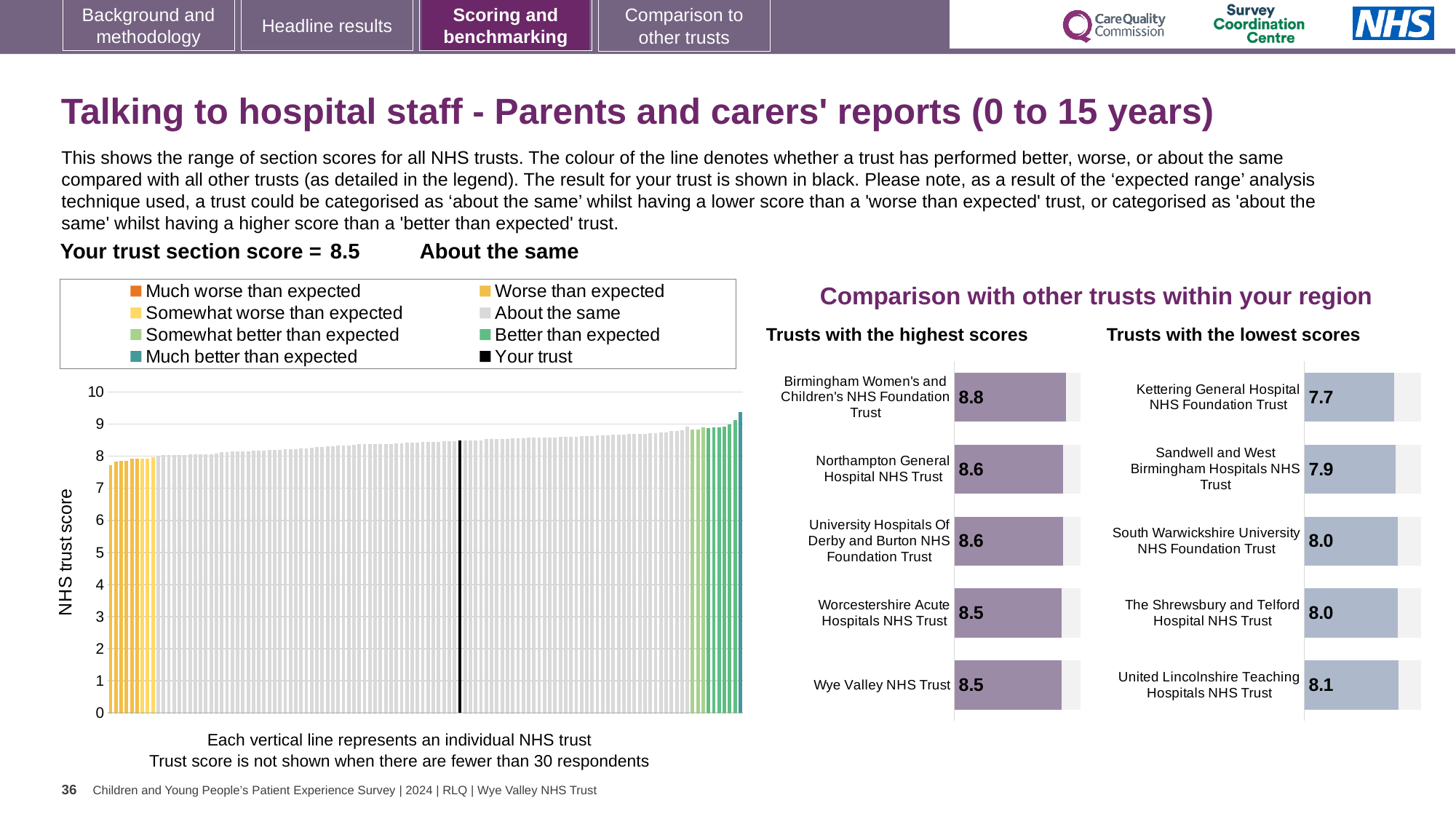
In the 'Trusts with the highest scores' chart, what is the score for Wye Valley NHS Trust? 8.5 In the 'Trusts with the lowest scores' chart, what is the difference between the score for United Lincolnshire Teaching Hospitals NHS Trust and the score for Kettering General Hospital NHS Foundation Trust? 0.4 What kind of chart is the large chart on the left showing NHS trust scores? Bar chart How many entries does the legend of the large chart on the left list? 8 In the 'Trusts with the lowest scores' chart, which trust has the highest score? United Lincolnshire Teaching Hospitals NHS Trust In the 'Trusts with the lowest scores' chart, which trust has the lowest score? Kettering General Hospital NHS Foundation Trust In the 'Trusts with the highest scores' chart, what is the difference between the score for Birmingham Women's and Children's NHS Foundation Trust and the score for Wye Valley NHS Trust? 0.3 How many trusts are listed in the 'Trusts with the highest scores' chart? 5 In the 'Trusts with the highest scores' chart, what is the score for Birmingham Women's and Children's NHS Foundation Trust? 8.8 Which is larger: the score for Northampton General Hospital NHS Trust in the 'Trusts with the highest scores' chart or the score for Sandwell and West Birmingham Hospitals NHS Trust in the 'Trusts with the lowest scores' chart? Northampton General Hospital NHS Trust In the 'Trusts with the lowest scores' chart, what is the score for Kettering General Hospital NHS Foundation Trust? 7.7 In the large chart on the left, do the bar heights rise or fall from left to right along the x axis? Rise